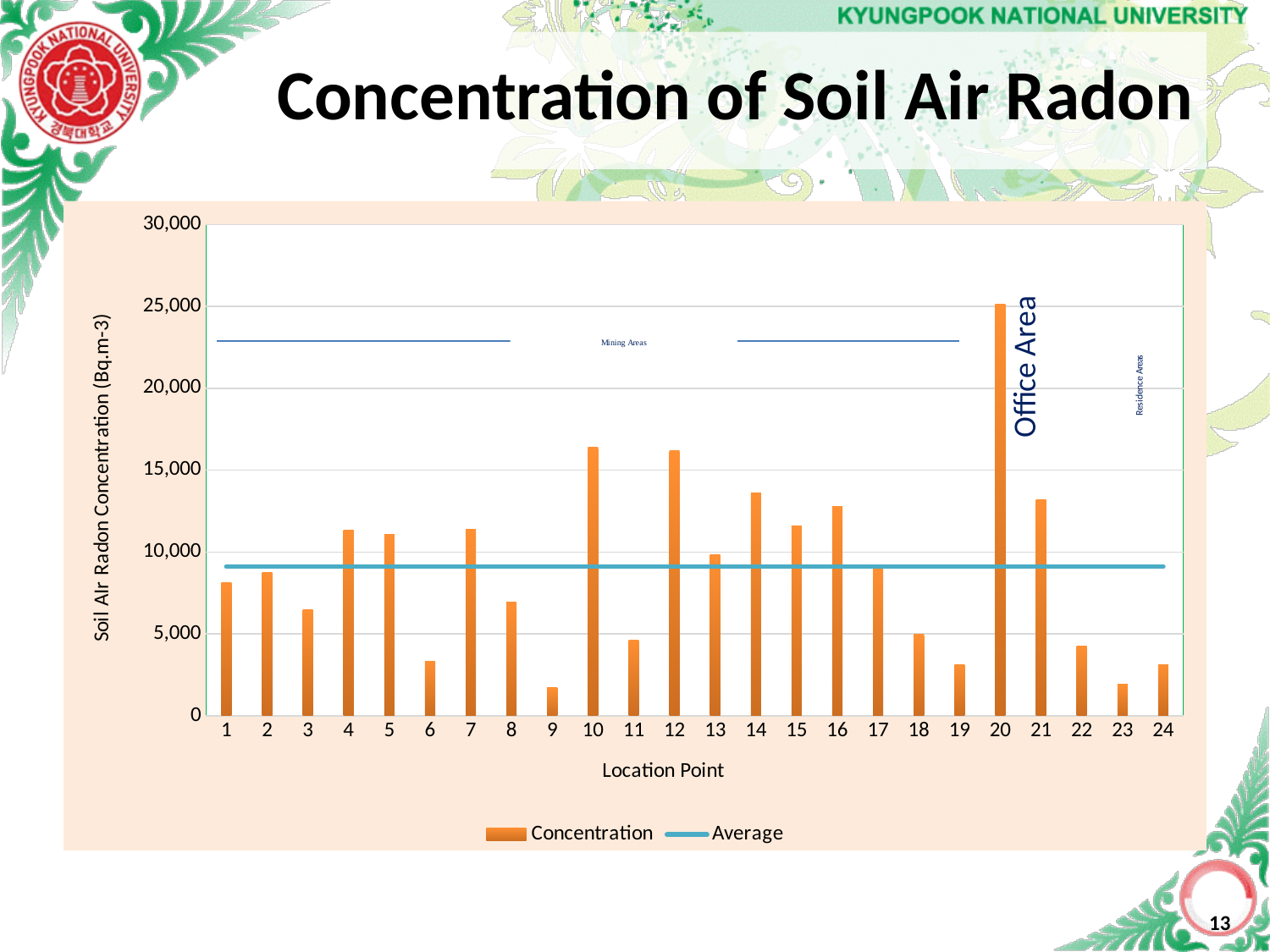
Which has the larger concentration, location point 20 or location point 21? 20 How many location points are plotted on the x axis? 24 Which has the larger concentration, location point 4 or location point 6? 4 Is the concentration at location point 20 greater or less than 20,000? greater Is the concentration at location point 10 greater or less than 15,000? greater What is the title of the slide's chart? Concentration of Soil Air Radon Is the concentration at location point 9 greater or less than 5,000? less What kind of chart is shown on the slide? Combination bar and line chart How many series does the legend list? 2 Which location point has the highest soil air radon concentration? 20 What are the two entries in the chart legend? Concentration and Average